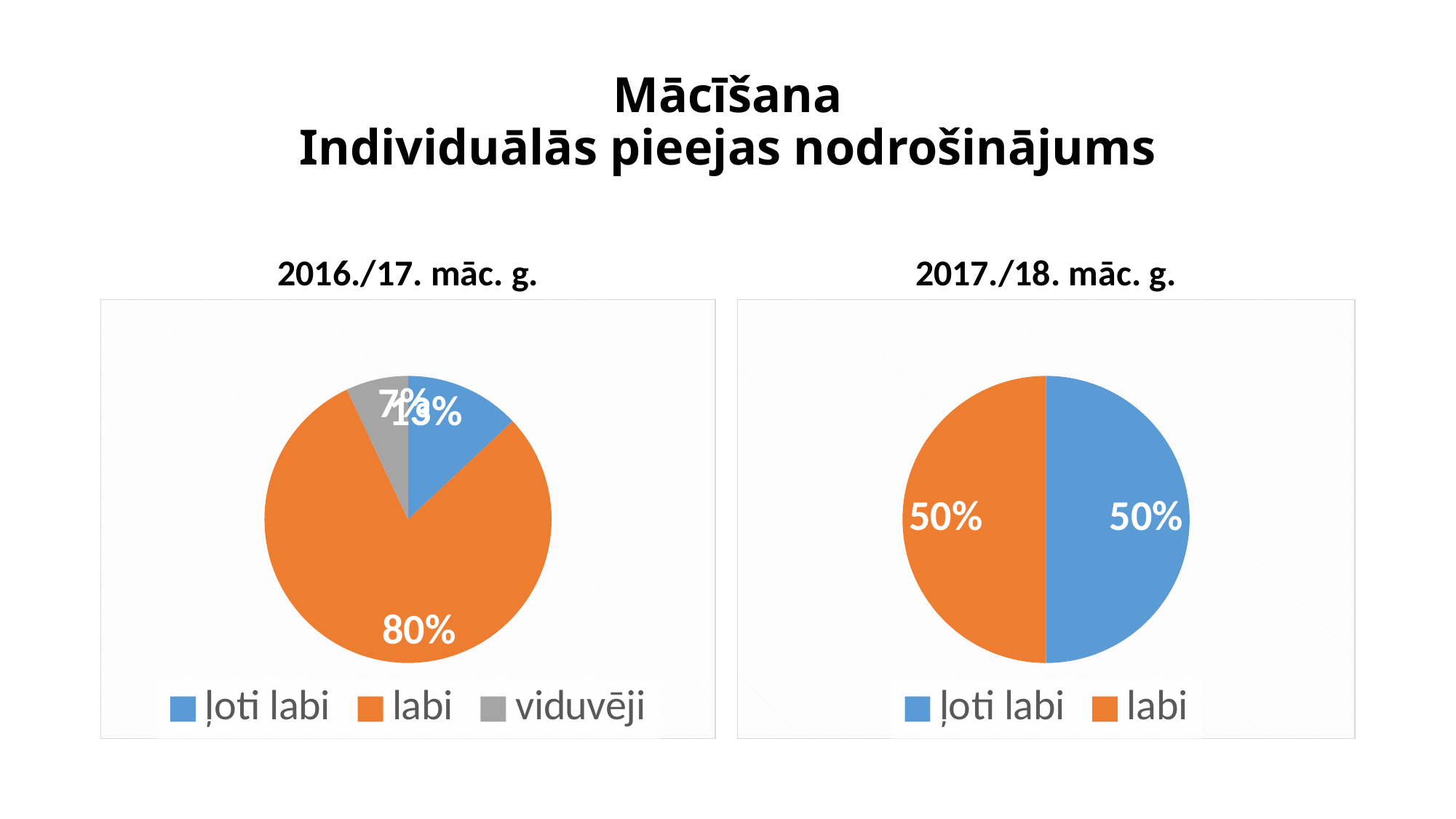
How many categories does the 2016./17. māc. g. pie chart have? 3 In the 2016./17. māc. g. chart, what share does "ļoti labi" have? 13% How many categories does the 2017./18. māc. g. pie chart have? 2 In the 2016./17. māc. g. chart, which category has the largest slice? labi What type of chart is shown for 2016./17. māc. g.? pie chart In the 2016./17. māc. g. chart, which category has the smallest slice? viduvēji In the 2016./17. māc. g. chart, how many percentage points larger is "labi" than "ļoti labi"? 67 In the 2016./17. māc. g. chart, which colour represents "viduvēji"? gray In the 2016./17. māc. g. chart, what share does "viduvēji" have? 7% In the 2016./17. māc. g. chart, what share does "labi" have? 80% In the 2017./18. māc. g. chart, what share does "labi" have? 50% In the 2017./18. māc. g. chart, what share does "ļoti labi" have? 50%